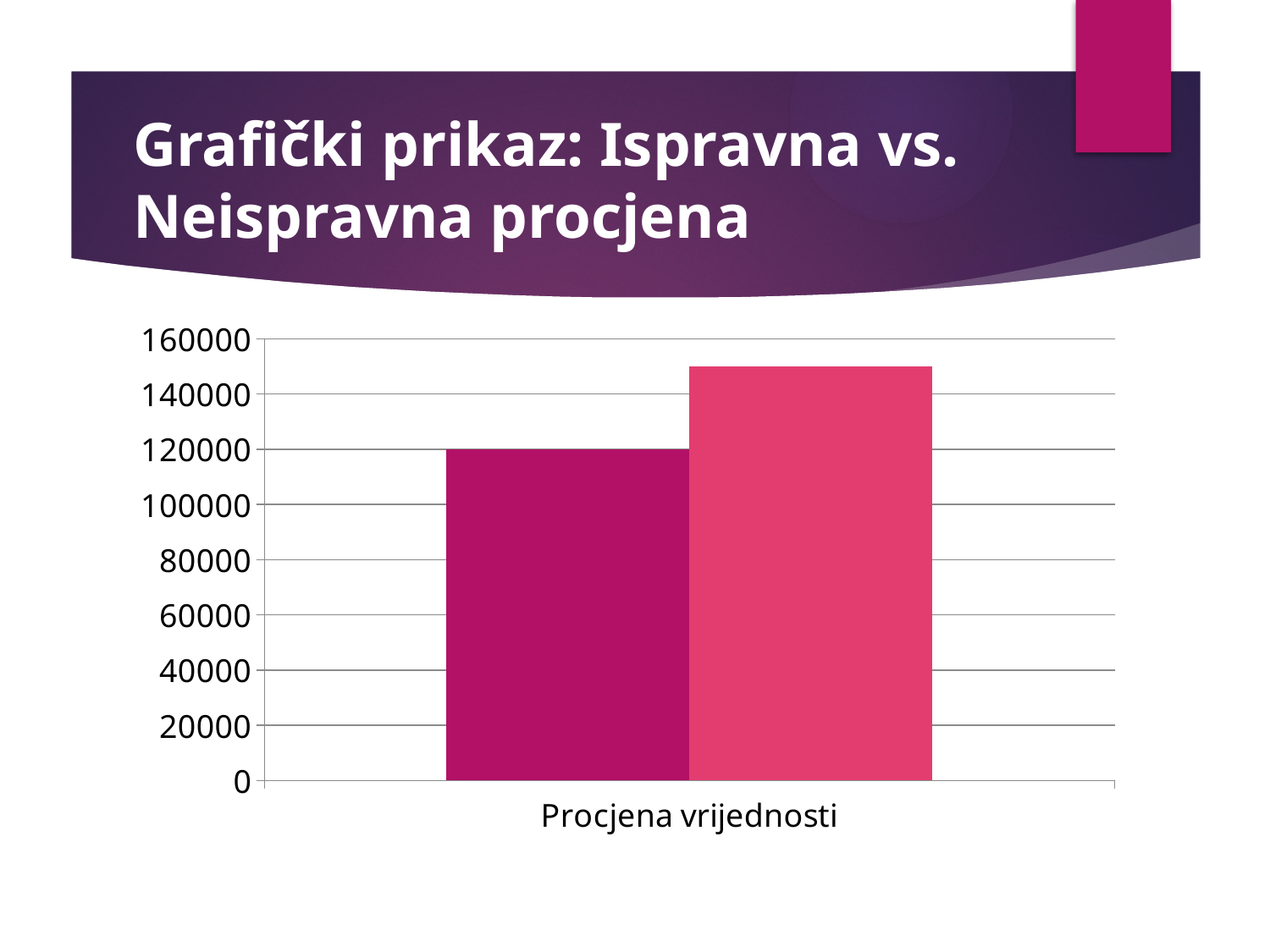
Is the value of the dark magenta (left) bar greater or less than 140000? less Is the value of the lighter pink (right) bar greater or less than 140000? greater What is the highest value shown on the y axis? 160000 How many bars are plotted in the chart? 2 What kind of chart is shown on the slide? bar chart Which bar is taller, the dark magenta (left) bar or the lighter pink (right) bar? the lighter pink (right) bar What is the category label shown on the x axis? Procjena vrijednosti What is the value of the dark magenta (left) bar for Procjena vrijednosti? 120000 How many categories are shown on the x axis of the chart? 1